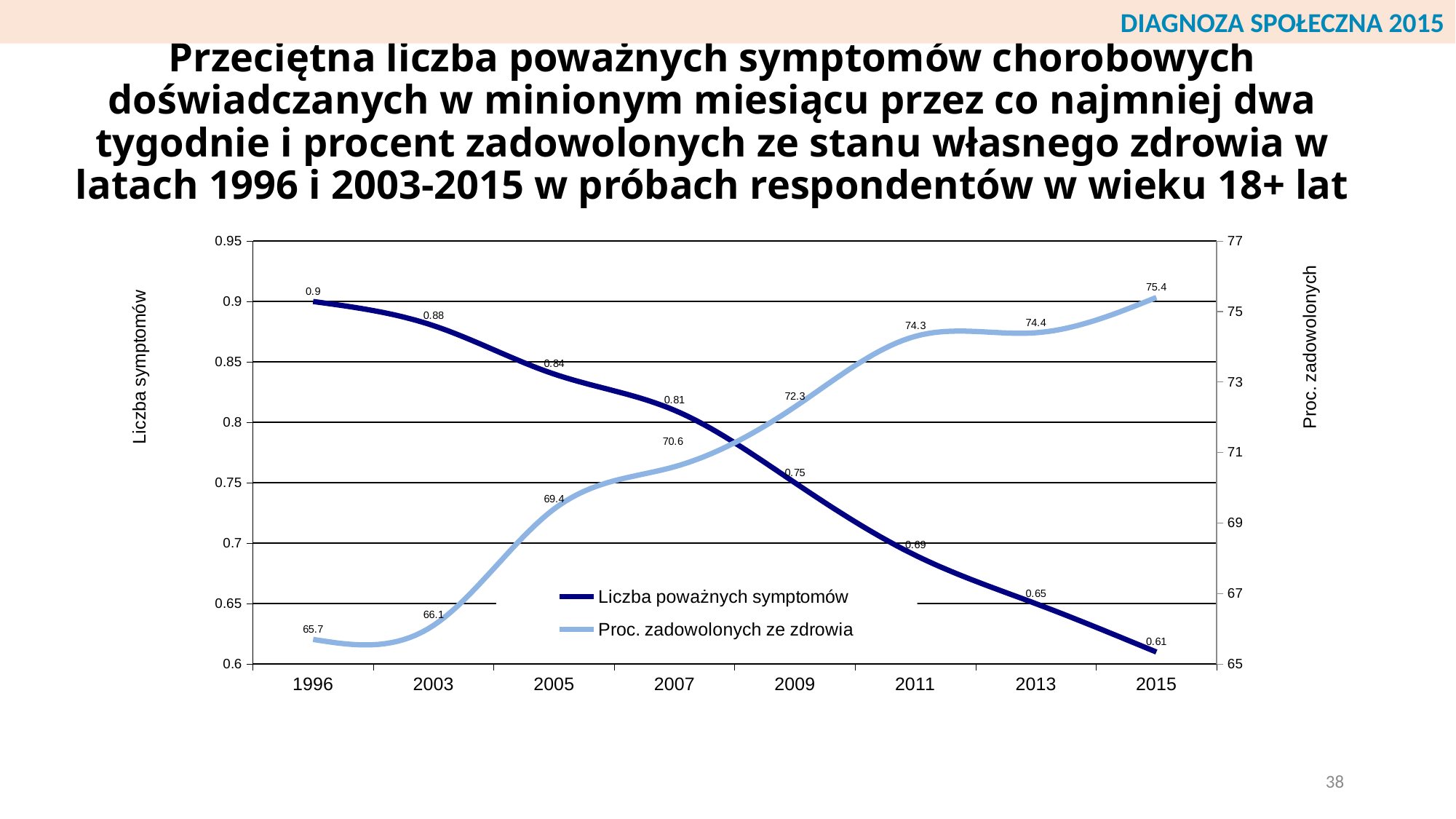
What type of chart is shown on the slide? line chart In which year is 'Proc. zadowolonych ze zdrowia' highest? 2015 Does 'Proc. zadowolonych ze zdrowia' rise or fall from 1996 to 2015? rise What is the value of 'Liczba poważnych symptomów' in 1996? 0.9 In which year is 'Liczba poważnych symptomów' lowest? 2015 What is the value of 'Liczba poważnych symptomów' in 2009? 0.75 How many years are plotted along the x axis? 8 What is the value of 'Proc. zadowolonych ze zdrowia' in 2005? 69.4 Which series is drawn in dark blue? Liczba poważnych symptomów How many series does the legend list? 2 What is the difference between the 'Liczba poważnych symptomów' values in 1996 and 2015? 0.29 What is the value of 'Proc. zadowolonych ze zdrowia' in 2015? 75.4